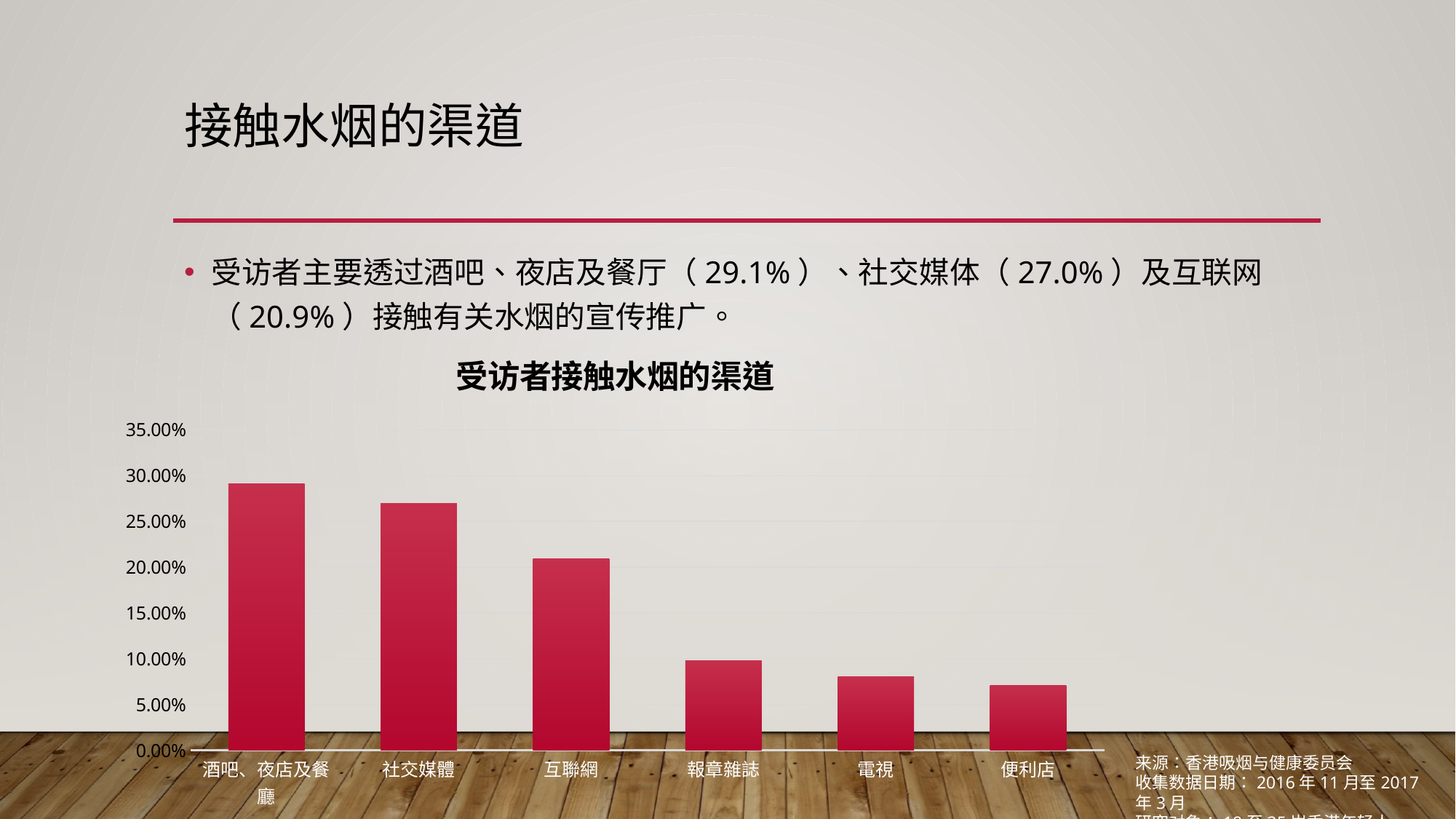
What kind of chart is shown on the slide? Bar chart Is the value for 社交媒體 greater or less than 25.00%? greater What is the difference between the values for 酒吧、夜店及餐廳 (29.1%) and 社交媒體 (27.0%)? 2.1% Which is larger, the value for 報章雜誌 or the value for 便利店? 報章雜誌 Which category has the lowest value in the chart? 便利店 Which category has the highest value in the chart? 酒吧、夜店及餐廳 According to the slide, what is the value for 互聯網? 20.9% How many categories are shown on the x axis of the chart? 6 Is the value for 電視 greater or less than 10.00%? less Do the bar values rise or fall from left to right along the x axis? Fall What is the title of the chart? 受访者接触水烟的渠道 According to the slide, what is the value for 社交媒體? 27.0%